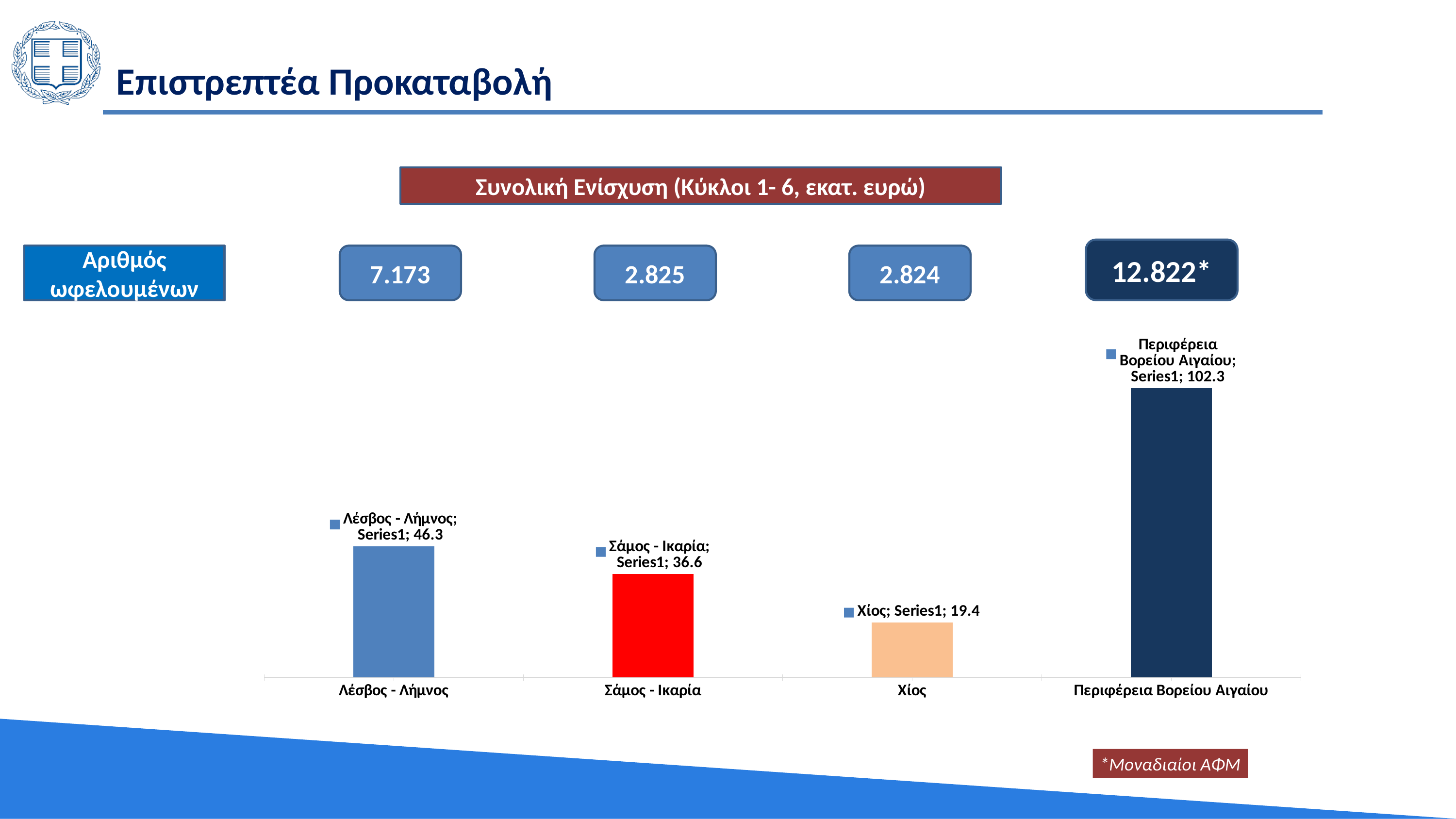
Which category has the highest value in the chart? Περιφέρεια Βορείου Αιγαίου What kind of chart is shown on the slide? Bar chart What is the difference between the values for Περιφέρεια Βορείου Αιγαίου and Λέσβος - Λήμνος? 56.0 What is the title of the chart? Συνολική Ενίσχυση (Κύκλοι 1- 6, εκατ. ευρώ) How many categories are shown in the chart? 4 What is the value for Χίος in the chart? 19.4 Which category has the lowest value in the chart? Χίος What is the value for Περιφέρεια Βορείου Αιγαίου in the chart? 102.3 Which has a larger value, Σάμος - Ικαρία or Χίος? Σάμος - Ικαρία What is the value for Λέσβος - Λήμνος in the chart? 46.3 What is the difference between the values for Λέσβος - Λήμνος and Σάμος - Ικαρία? 9.7 What is the value for Σάμος - Ικαρία in the chart? 36.6